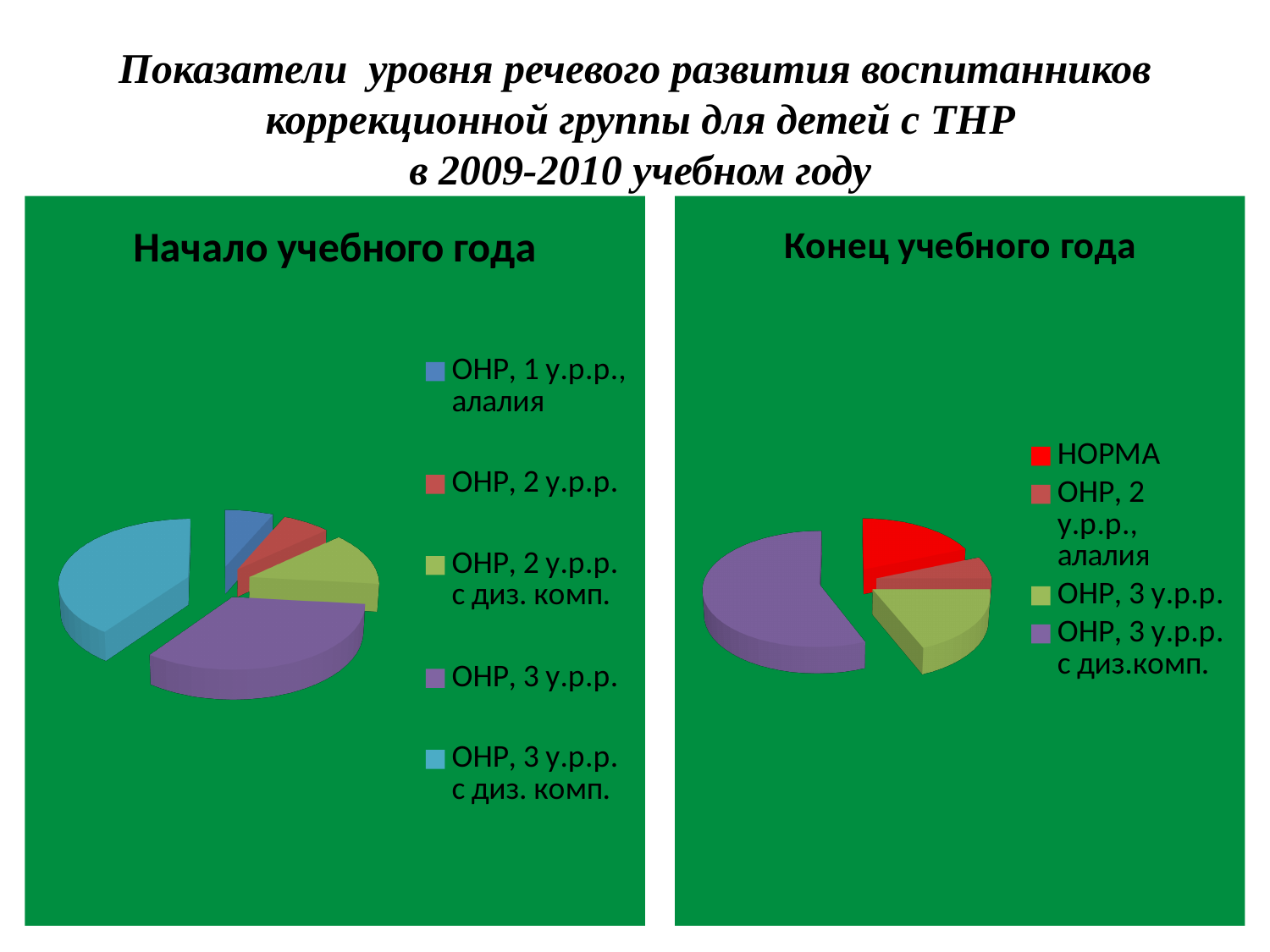
How many categories does the legend of the "Конец учебного года" chart list? 4 In the "Конец учебного года" chart, what colour is the "НОРМА" slice? red How many categories does the legend of the "Начало учебного года" chart list? 5 What is the title of the chart on the left side of the slide? Начало учебного года In the "Начало учебного года" chart, which slice is larger: "ОНР, 3 у.р.р." or "ОНР, 2 у.р.р."? ОНР, 3 у.р.р. What kind of chart is the "Начало учебного года" chart? pie chart In the "Конец учебного года" chart, which category has the largest slice? ОНР, 3 у.р.р. с диз.комп. In the "Конец учебного года" chart, which category has the smallest slice? ОНР, 2 у.р.р., алалия What kind of chart is the "Конец учебного года" chart? pie chart In the "Конец учебного года" chart, which slice is larger: "ОНР, 3 у.р.р. с диз.комп." or "ОНР, 3 у.р.р."? ОНР, 3 у.р.р. с диз.комп.